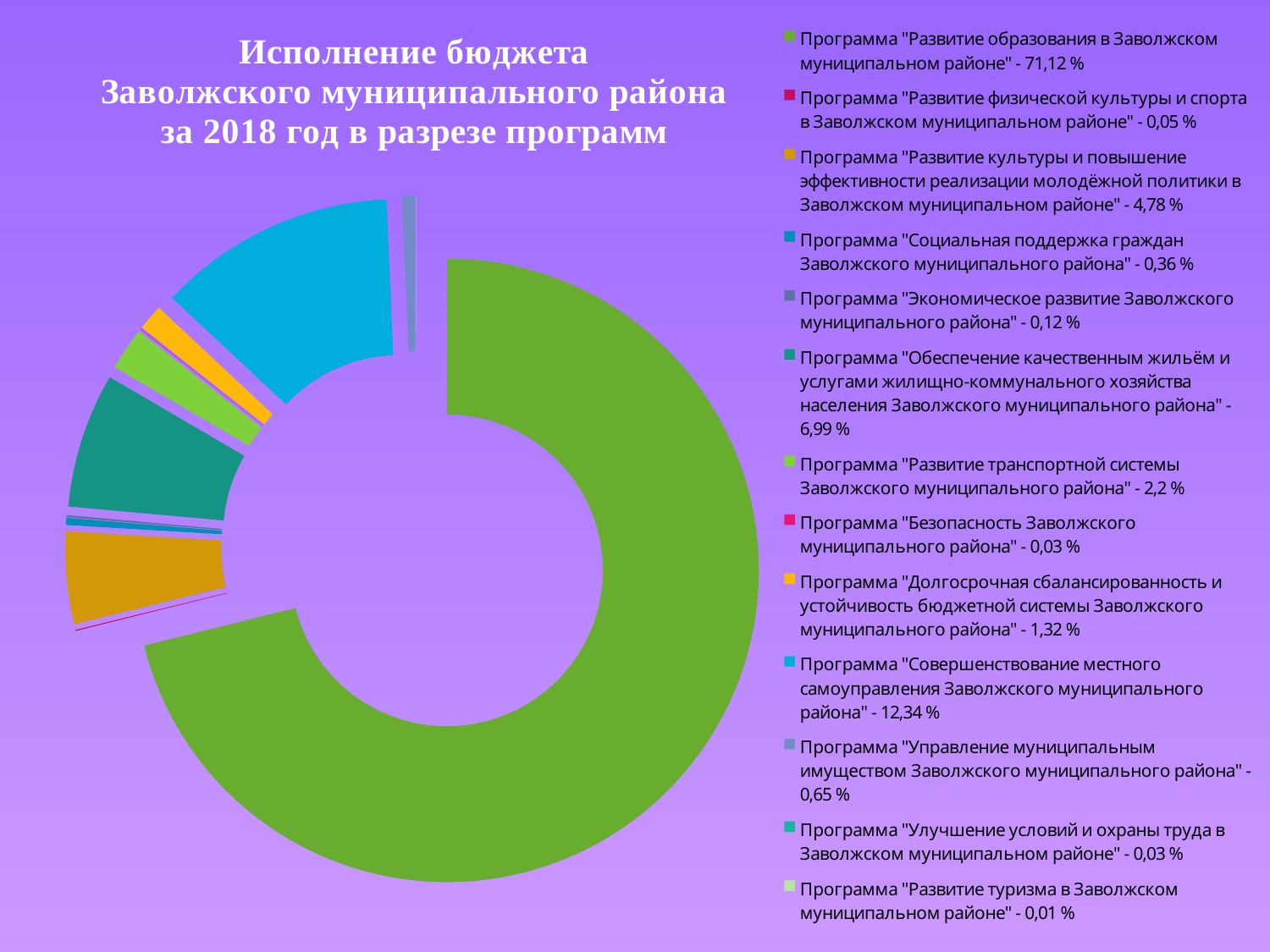
What share is shown for the programme "Развитие транспортной системы Заволжского муниципального района"? 2,2 % What share of the budget does the programme "Развитие образования в Заволжском муниципальном районе" account for? 71,12 % What share is shown for the programme "Совершенствование местного самоуправления Заволжского муниципального района"? 12,34 % By how many percentage points does the share of "Развитие образования" exceed the share of "Совершенствование местного самоуправления"? 58,78 What kind of chart is shown on the slide? Doughnut (pie) chart Which programme has the largest share of the budget? Программа "Развитие образования в Заволжском муниципальном районе" Which has the larger share: the programme "Развитие культуры и повышение эффективности реализации молодёжной политики" or the programme "Обеспечение качественным жильём и услугами жилищно-коммунального хозяйства"? Программа "Обеспечение качественным жильём и услугами жилищно-коммунального хозяйства населения Заволжского муниципального района" How many programmes (categories) does the legend list? 13 Which programme has the smallest share of the budget? Программа "Развитие туризма в Заволжском муниципальном районе" What colour is the segment for the programme "Развитие образования в Заволжском муниципальном районе"? Green What share is shown for the programme "Обеспечение качественным жильём и услугами жилищно-коммунального хозяйства населения Заволжского муниципального района"? 6,99 % What is the title of the chart? Исполнение бюджета Заволжского муниципального района за 2018 год в разрезе программ